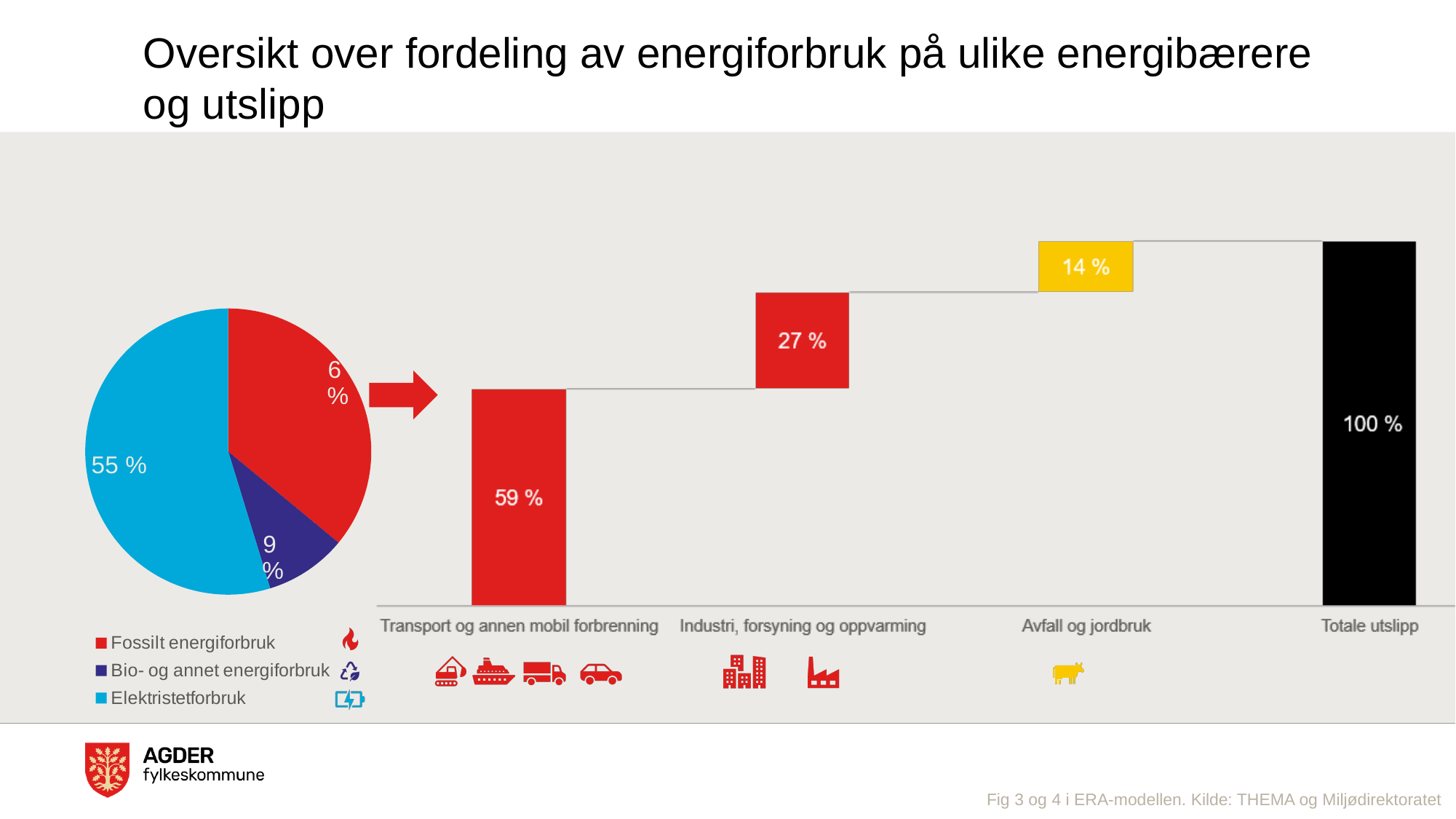
In the bar chart on the right, which of the three sector categories has the highest value? Transport og annen mobil forbrenning In the bar chart on the right, what is the value for Transport og annen mobil forbrenning? 59 % In the bar chart on the right, what is the value for Avfall og jordbruk? 14 % In the pie chart on the left, which category has the largest slice? Elektristetforbruk In the pie chart on the left, what is the share for Elektristetforbruk? 55 % In the bar chart on the right, which of the three sector categories has the lowest value? Avfall og jordbruk In the bar chart on the right, what is the difference between the values for Transport og annen mobil forbrenning and Industri, forsyning og oppvarming? 32 % How many entries does the legend of the pie chart on the left list? 3 In the bar chart on the right, how many categories are shown on the x axis? 4 In the bar chart on the right, what is the value for Industri, forsyning og oppvarming? 27 % In the bar chart on the right, what is the value for Totale utslipp? 100 % In the pie chart on the left, what is the share for Bio- og annet energiforbruk? 9 %